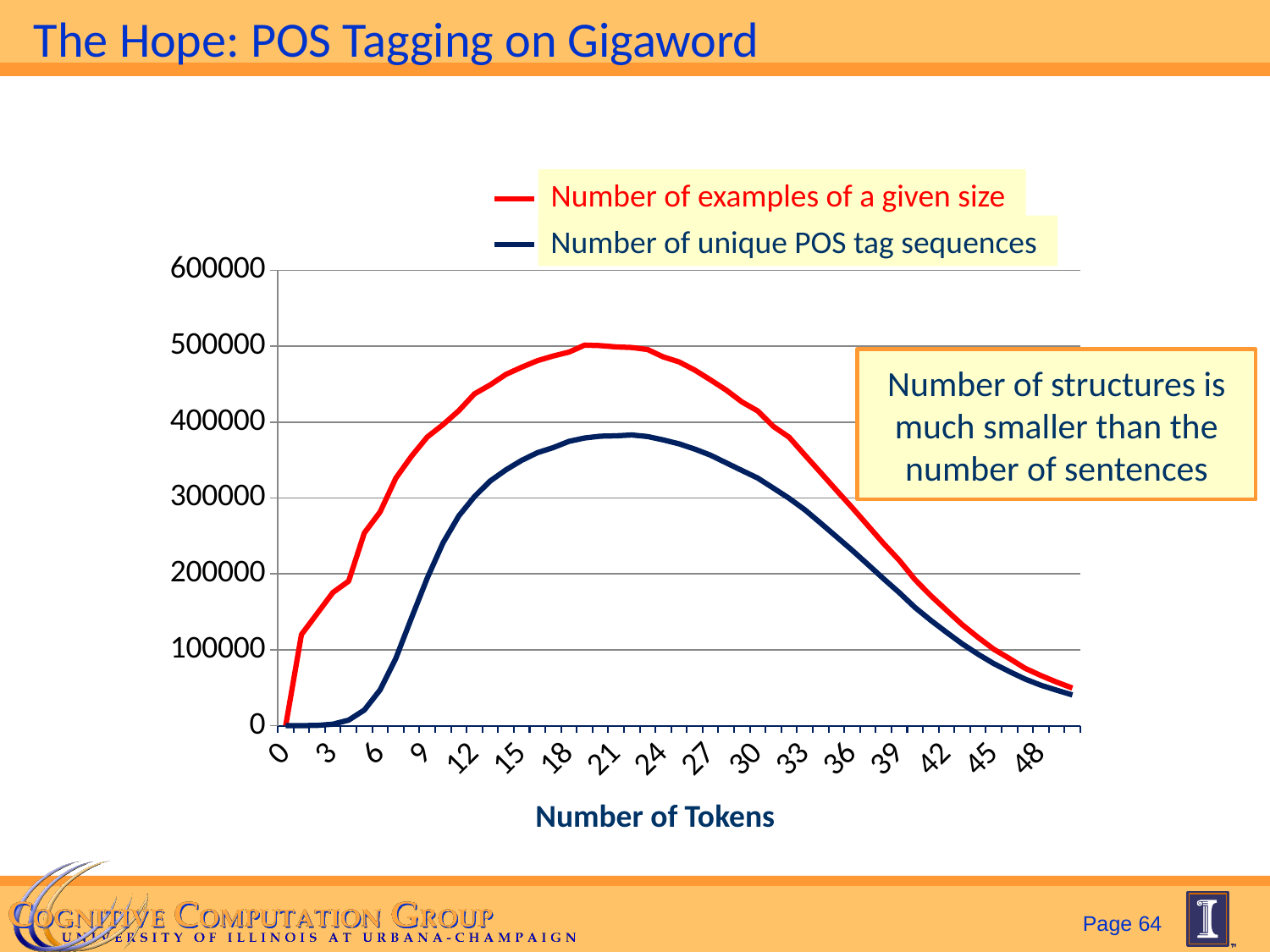
What kind of chart is shown on the slide? line chart Is the value of Number of examples of a given size at 3 tokens greater or less than 100000? greater Is the value of Number of unique POS tag sequences at 39 tokens greater or less than 200000? less Which series is drawn in red? Number of examples of a given size At 21 tokens, which series has the larger value: Number of examples of a given size or Number of unique POS tag sequences? Number of examples of a given size Which series reaches the higher peak value? Number of examples of a given size How many series does the legend list? 2 Is the value of Number of examples of a given size at 39 tokens greater or less than 200000? greater What is the title of the x axis? Number of Tokens Does the Number of examples of a given size series rise or fall between 24 and 48 tokens? fall